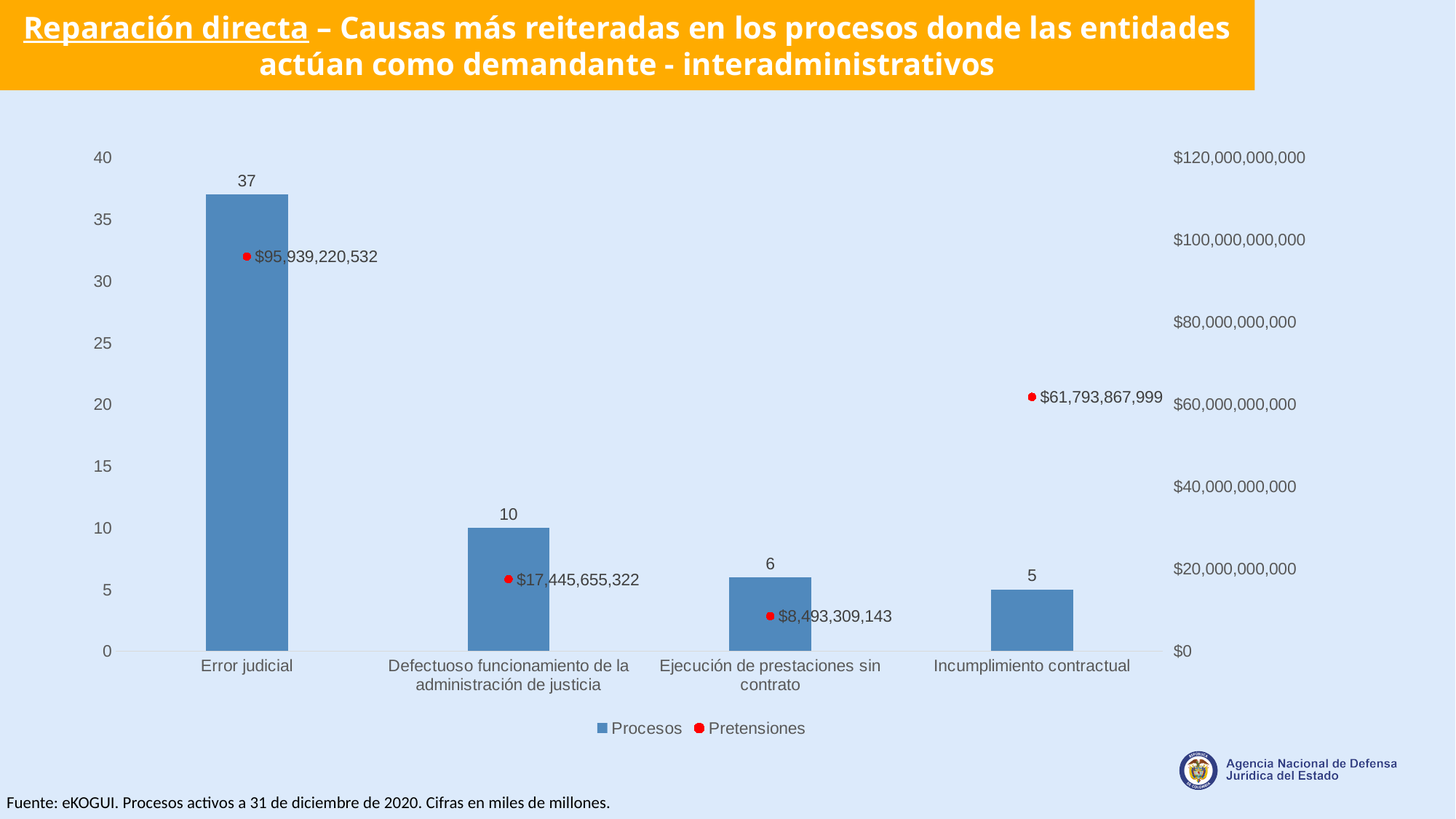
Which category has the lowest Pretensiones value? Ejecución de prestaciones sin contrato How many categories are shown on the x axis? 4 Which has a larger Pretensiones value, Incumplimiento contractual or Defectuoso funcionamiento de la administración de justicia? Incumplimiento contractual How many series does the legend list? 2 How many Procesos are shown for Error judicial? 37 What is the difference in Procesos between Error judicial and Defectuoso funcionamiento de la administración de justicia? 27 What colour are the Pretensiones markers? red What is the Pretensiones value for Defectuoso funcionamiento de la administración de justicia? $17,445,655,322 Do the Procesos values rise or fall from left to right across the categories? fall How many Procesos are shown for Ejecución de prestaciones sin contrato? 6 Which category has the highest number of Procesos? Error judicial What is the Pretensiones value for Incumplimiento contractual? $61,793,867,999